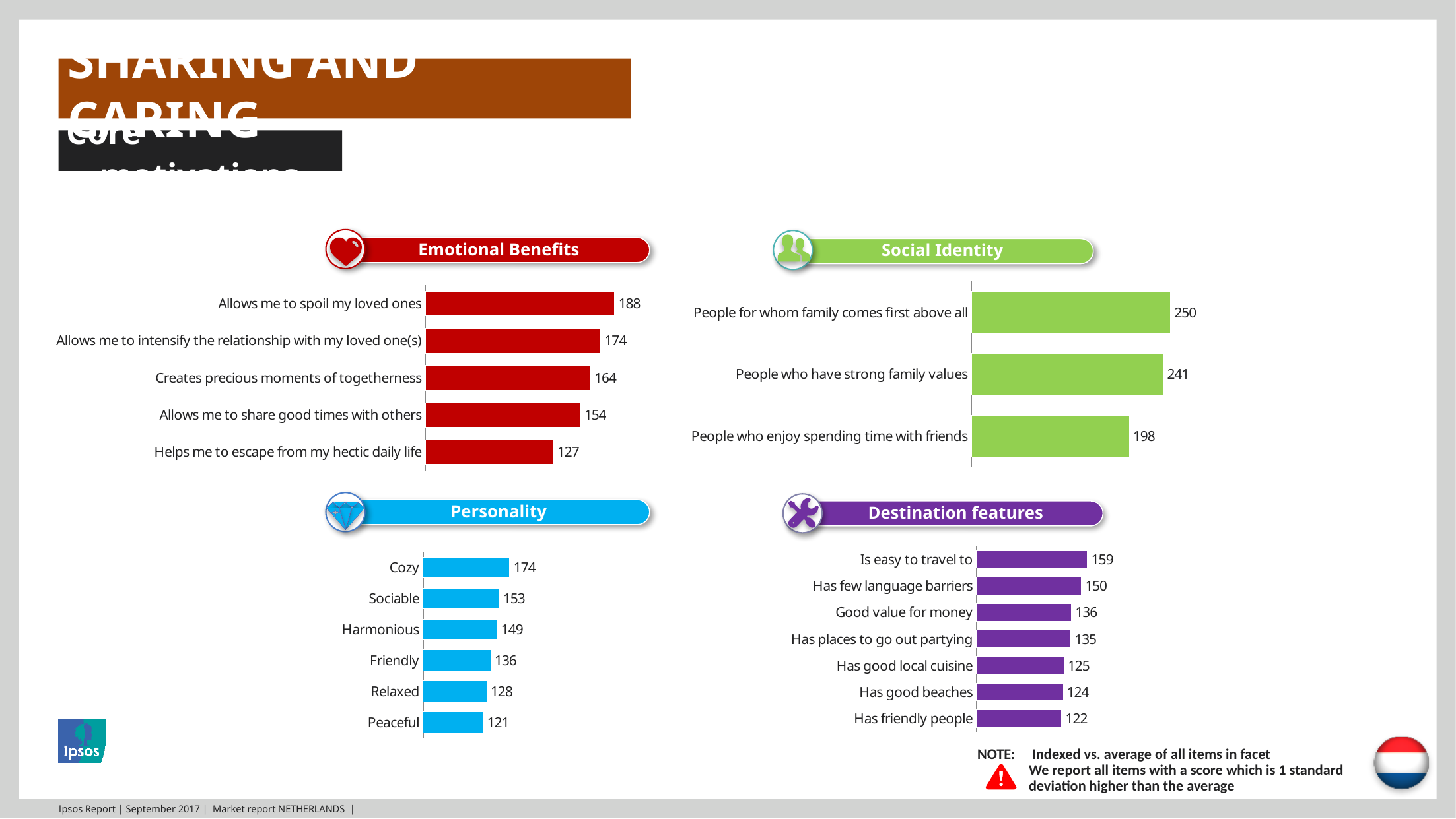
In the Emotional Benefits chart, what is the value for "Allows me to spoil my loved ones"? 188 In the Personality chart, how many categories are shown? 6 In the Social Identity chart, what is the difference between "People for whom family comes first above all" and "People who enjoy spending time with friends"? 52 In the Personality chart, what is the value for Harmonious? 149 In the Social Identity chart, which category has the highest value? People for whom family comes first above all In the Emotional Benefits chart, which category has the lowest value? Helps me to escape from my hectic daily life In the Destination features chart, what is the difference between "Is easy to travel to" and "Has friendly people"? 37 In the Destination features chart, how many categories are shown? 7 In the Social Identity chart, what is the value for "People who have strong family values"? 241 In the Destination features chart, what is the value for "Has good beaches"? 124 In the Personality chart, which is larger, Sociable or Relaxed? Sociable What kind of chart is the Emotional Benefits chart? Bar chart